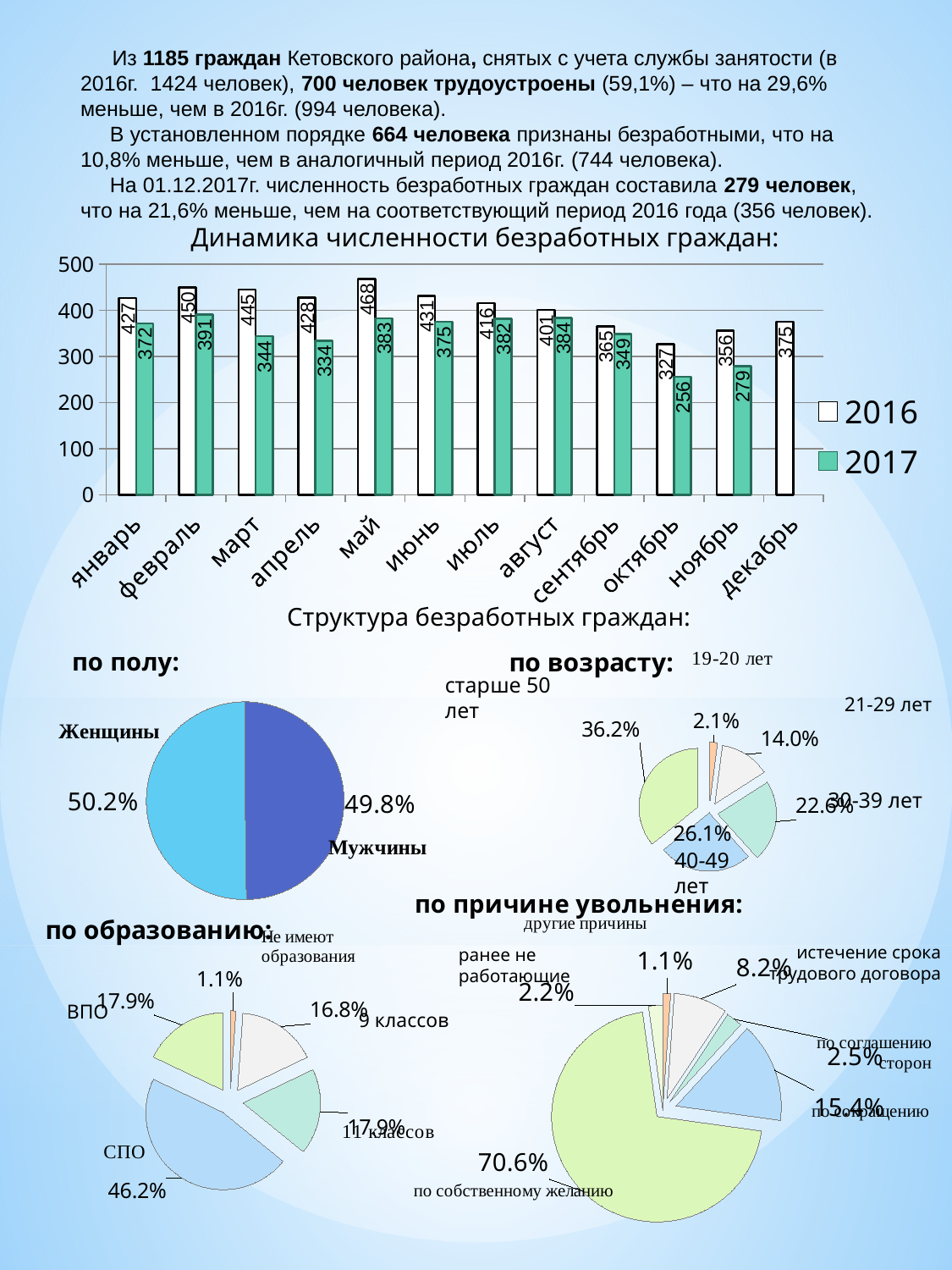
In the pie chart 'по образованию', what share is СПО? 46.2% In the pie chart 'по причине увольнения', which is larger: истечение срока трудового договора or по соглашению сторон? истечение срока трудового договора In the pie chart 'по полу', what share is Женщины? 50.2% In the chart 'Динамика численности безработных граждан', which month has the lowest value in the 2017 series? октябрь What kind of chart is 'Динамика численности безработных граждан'? bar chart In the chart 'Динамика численности безработных граждан', which month has the highest value in the 2016 series? май In the pie chart 'по причине увольнения', what share is по сокращению? 15.4% In the chart 'Динамика численности безработных граждан', how many series does the legend list? 2 In the chart 'Динамика численности безработных граждан', what is the value for октябрь in the 2017 series? 256 In the pie chart 'по возрасту', which age group has the largest share? старше 50 лет In the chart 'Динамика численности безработных граждан', what is the value for май in the 2016 series? 468 In the chart 'Динамика численности безработных граждан', what is the difference between the 2016 and 2017 values for март? 101